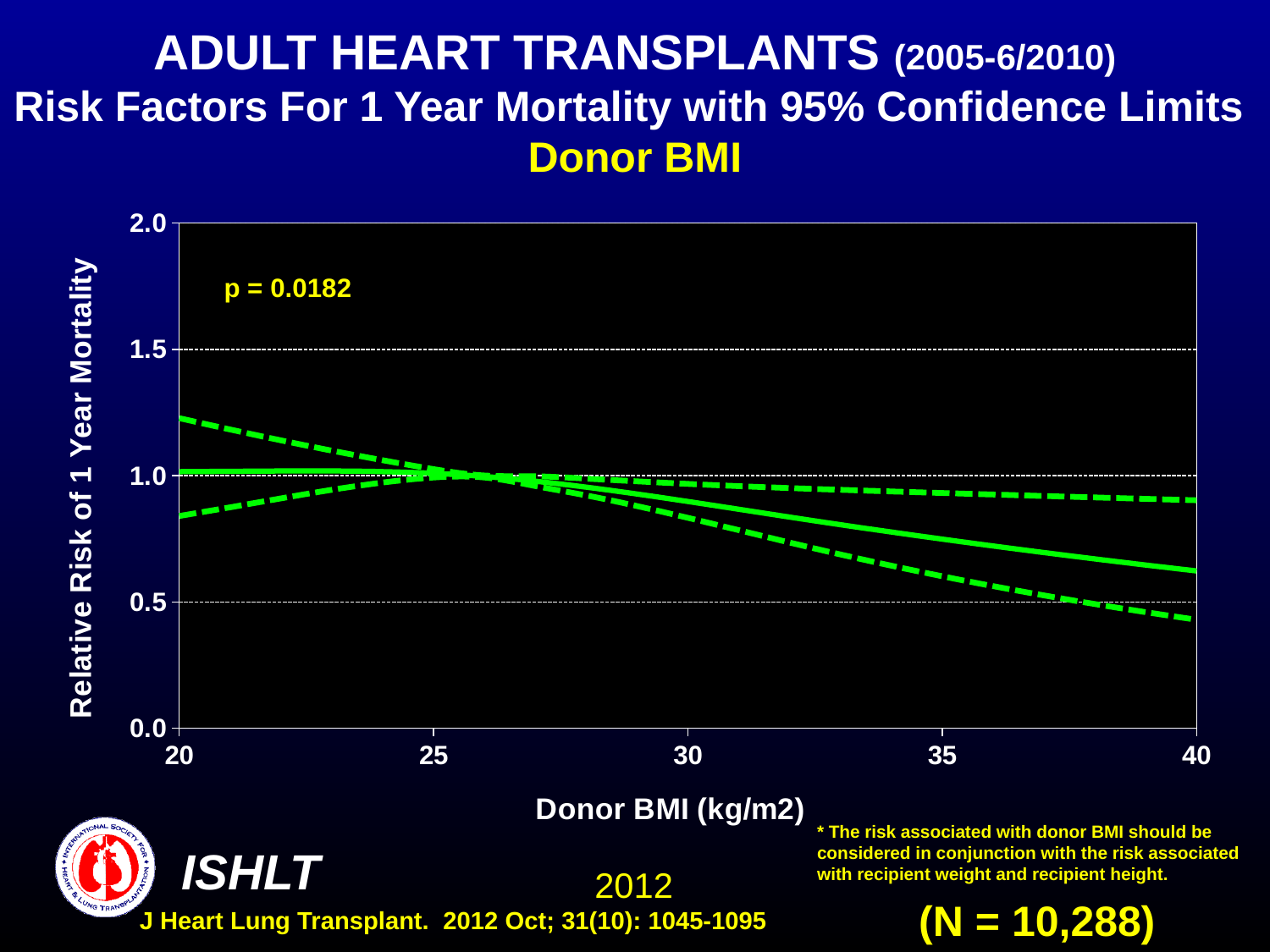
What is the label of the x axis? Donor BMI (kg/m2) What p-value is printed on the chart? p = 0.0182 Is the upper confidence limit (upper dashed line) at a donor BMI of 20 greater or less than 1.0? greater Is the relative risk (solid line) at a donor BMI of 40 greater or less than 0.5? greater Is the upper confidence limit (upper dashed line) at a donor BMI of 40 greater or less than 1.0? less Does the solid relative risk line rise or fall as donor BMI increases from 20 to 40? fall How many lines are plotted on the chart? 3 What kind of chart is shown on the slide? line chart